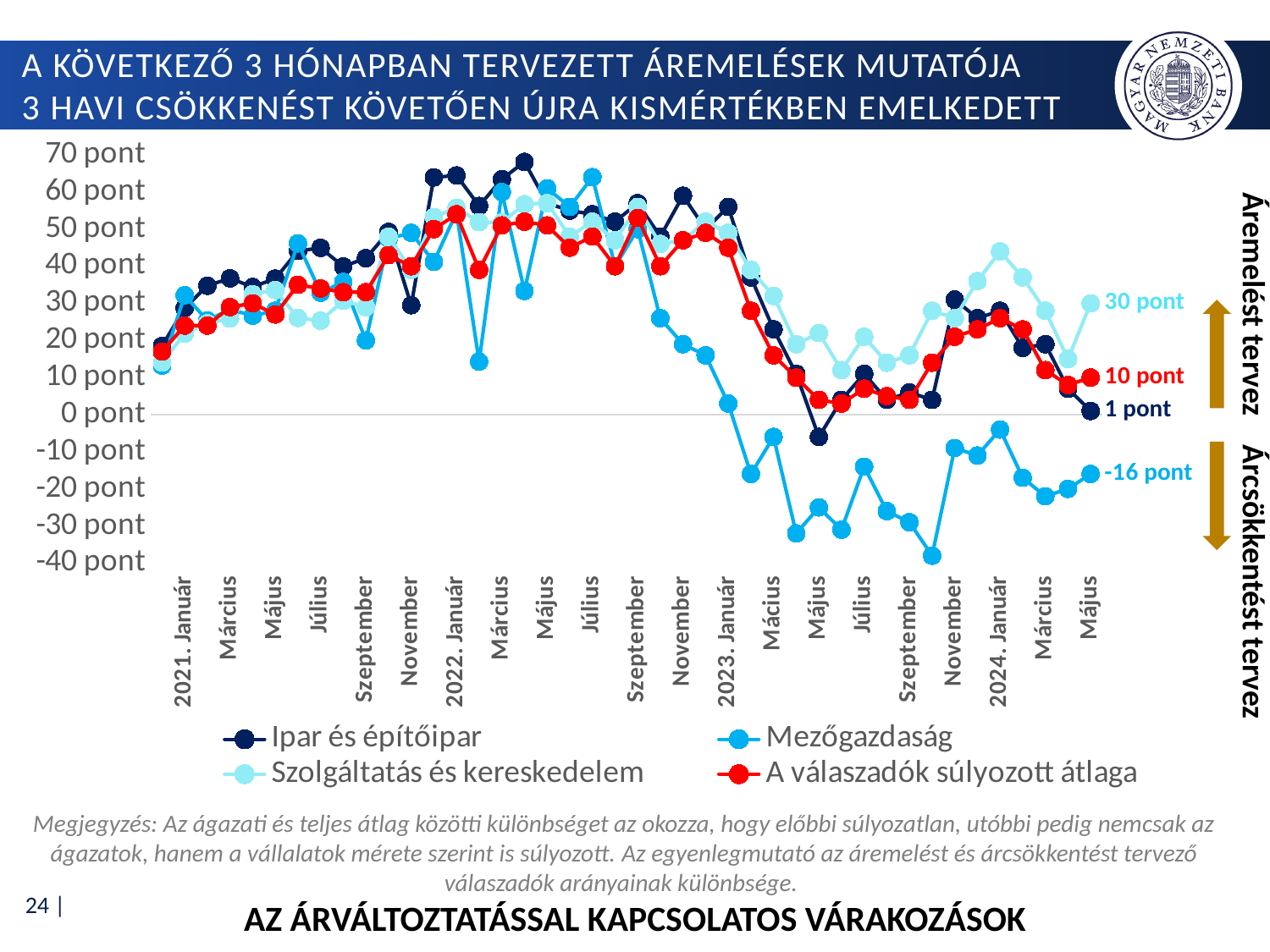
What is the value of Mezőgazdaság at the last point (2024 Május)? -16 pont What is the difference between the Szolgáltatás és kereskedelem value and the Mezőgazdaság value at 2024 Május? 46 pont Does A válaszadók súlyozott átlaga rise or fall between 2023 Január and 2023 Május? fall Which series has the lowest value at 2024 Május? Mezőgazdaság What is the value of A válaszadók súlyozott átlaga at the last point (2024 Május)? 10 pont At 2024 Május, which is larger: Ipar és építőipar or A válaszadók súlyozott átlaga? A válaszadók súlyozott átlaga Which series has the highest value at 2024 Május? Szolgáltatás és kereskedelem What is the value of Ipar és építőipar at the last point (2024 Május)? 1 pont What is the value of Szolgáltatás és kereskedelem at the last point (2024 Május)? 30 pont Is the value for Mezőgazdaság at 2023 Május greater or less than 0 pont? less What kind of chart is shown on the slide? line chart How many series does the legend list? 4